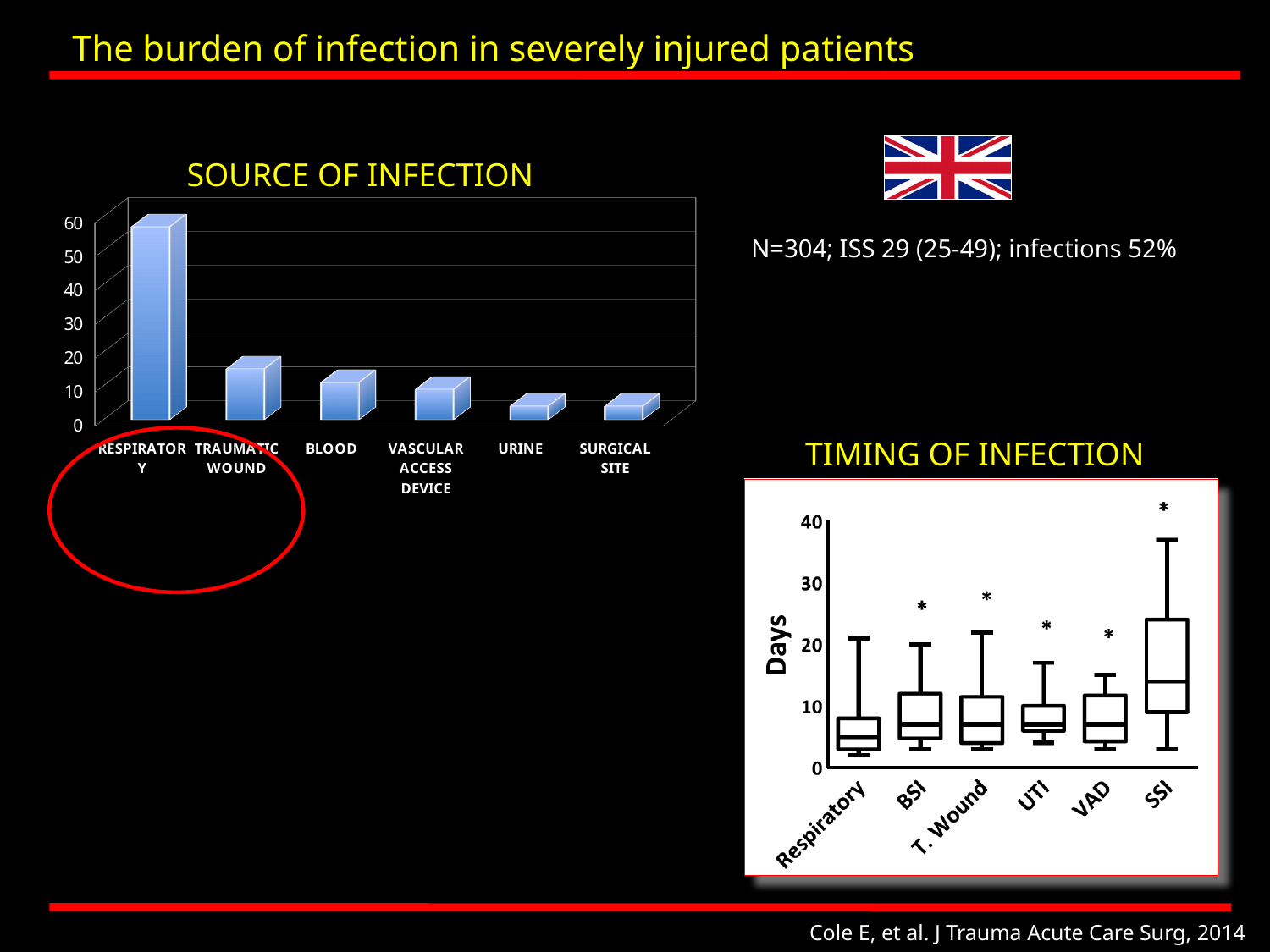
What kind of chart is the SOURCE OF INFECTION chart? bar chart How many infection sources are shown in the SOURCE OF INFECTION chart? 6 In the SOURCE OF INFECTION chart, is the value for TRAUMATIC WOUND greater or less than 20? less In the SOURCE OF INFECTION chart, which is larger, the value for BLOOD or the value for SURGICAL SITE? BLOOD In the TIMING OF INFECTION chart, which category has the highest median number of days? SSI In the SOURCE OF INFECTION chart, which source has the highest value? RESPIRATORY In the SOURCE OF INFECTION chart, is the value for URINE greater or less than 10? less In the SOURCE OF INFECTION chart, which is larger, the value for RESPIRATORY or the value for TRAUMATIC WOUND? RESPIRATORY What is the y-axis label of the TIMING OF INFECTION chart? Days How many infection categories are shown in the TIMING OF INFECTION chart? 6 What kind of chart is the TIMING OF INFECTION chart? box plot In the SOURCE OF INFECTION chart, is the value for RESPIRATORY greater or less than 50? greater